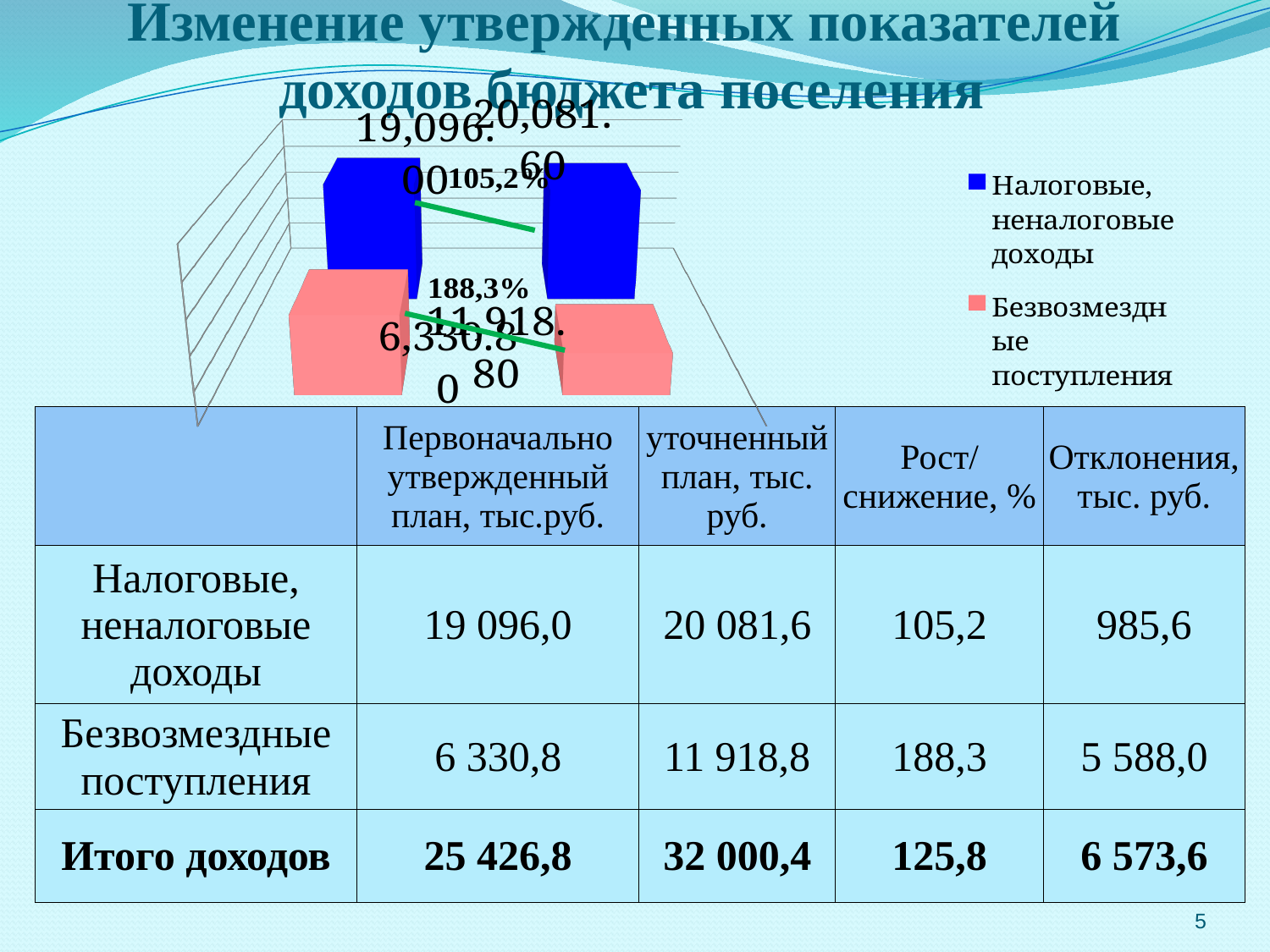
What is the data label on the left pink bar (Безвозмездные поступления)? 6,330.80 What is the data label on the right blue bar (Налоговые, неналоговые доходы)? 20,081.60 Which series is shown in blue in the chart? Налоговые, неналоговые доходы What is the difference between the right and left blue bars (Налоговые, неналоговые доходы)? 985.60 What is the data label on the right pink bar (Безвозмездные поступления)? 11,918.80 How many bars are plotted in the chart in total? 4 Do the values for Безвозмездные поступления rise or fall from the left bar to the right bar? rise Which series is shown in pink in the chart? Безвозмездные поступления What kind of chart is shown on the slide? bar chart What percentage label is shown on the line connecting the two pink bars (Безвозмездные поступления)? 188,3% What is the data label on the left blue bar (Налоговые, неналоговые доходы)? 19,096.00 How many series does the chart legend list? 2